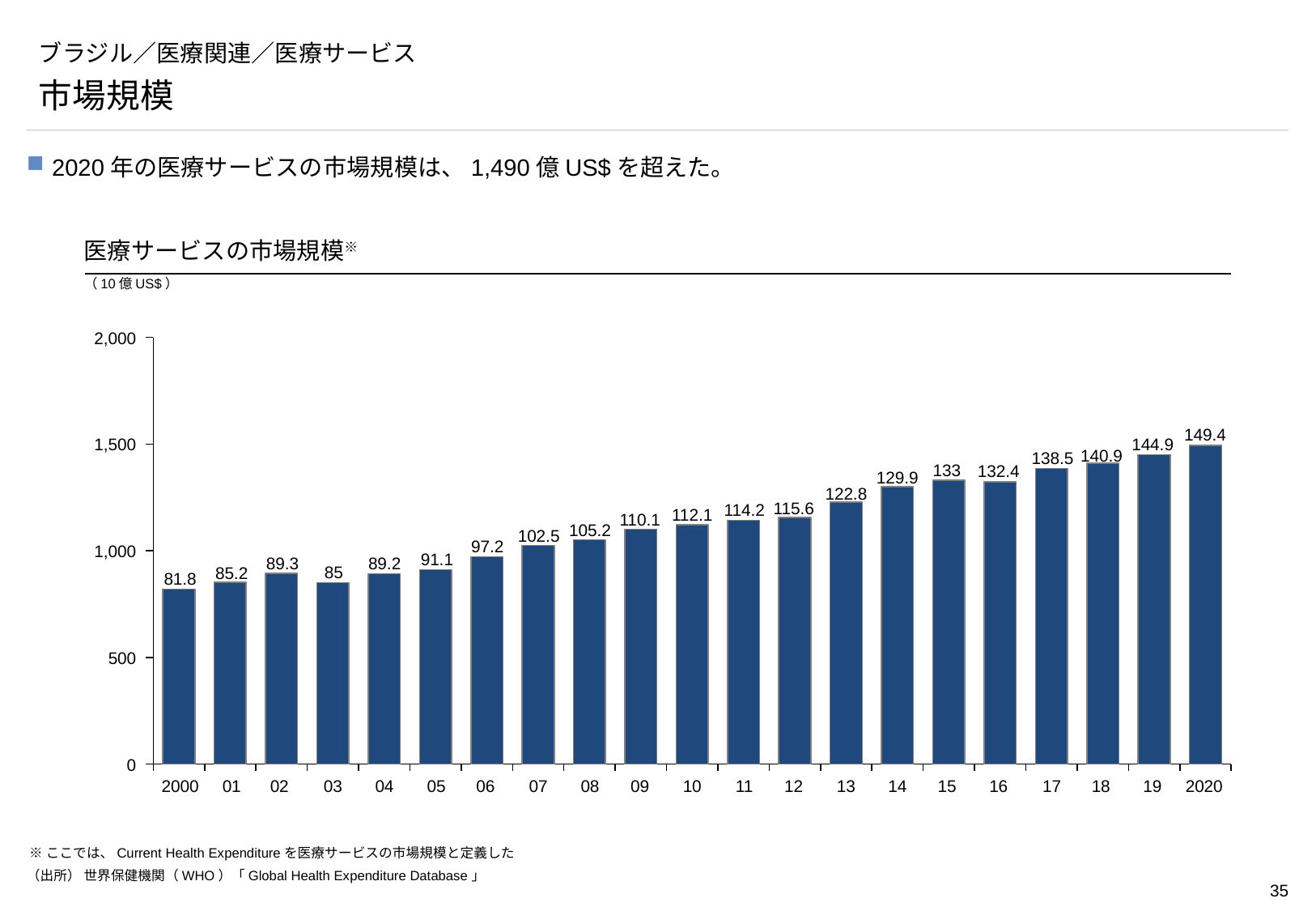
What is the difference between the values for 2015 and 2016? 0.6 Which year has the highest value in the chart? 2020 What kind of chart is shown on the slide? bar chart What is the value for 2020 in the 医療サービスの市場規模 chart? 149.4 What is the value for 2016 in the chart? 132.4 Which is larger, the value for 2003 or the value for 2002? 2002 Which year has the lowest value in the chart? 2000 What is the difference between the values for 2020 and 2019? 4.5 How many years (bars) are shown in the chart? 21 What is the value for 2000 in the chart? 81.8 What unit is shown for the values in the chart? 10億US$ What is the value for 2013 in the chart? 122.8